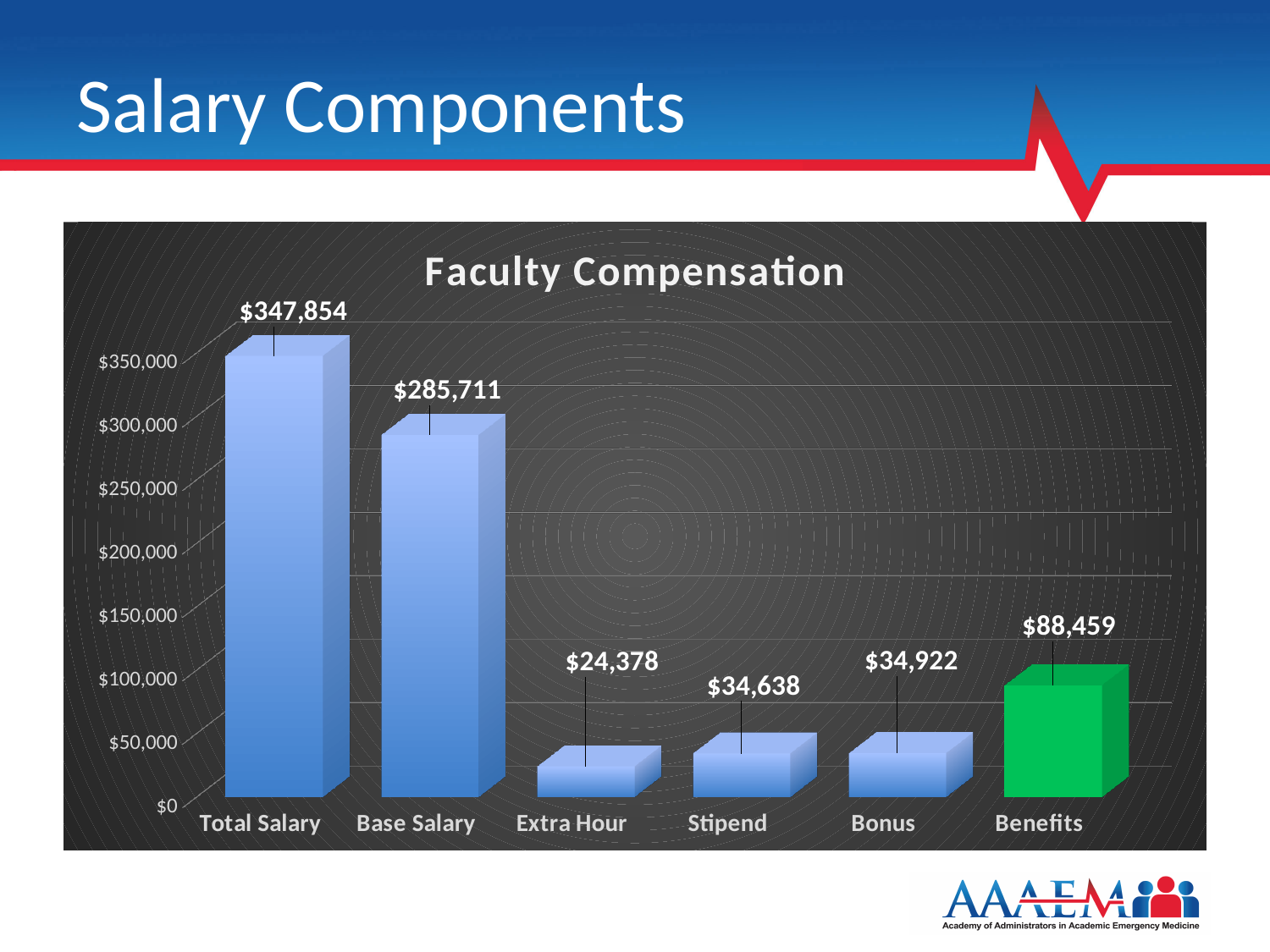
What is the difference between Bonus and Stipend in the Faculty Compensation chart? $284 How many categories are shown in the Faculty Compensation chart? 6 Which category has the highest value in the Faculty Compensation chart? Total Salary What is the difference between Total Salary and Base Salary in the Faculty Compensation chart? $62,143 What is the value for Total Salary in the Faculty Compensation chart? $347,854 What is the value for Extra Hour in the Faculty Compensation chart? $24,378 Is the value for Benefits in the Faculty Compensation chart greater or less than $100,000? less What is the value for Base Salary in the Faculty Compensation chart? $285,711 Which is larger in the Faculty Compensation chart, Benefits or Stipend? Benefits Which category has the lowest value in the Faculty Compensation chart? Extra Hour What is the value for Benefits in the Faculty Compensation chart? $88,459 What kind of chart is the Faculty Compensation chart? bar chart